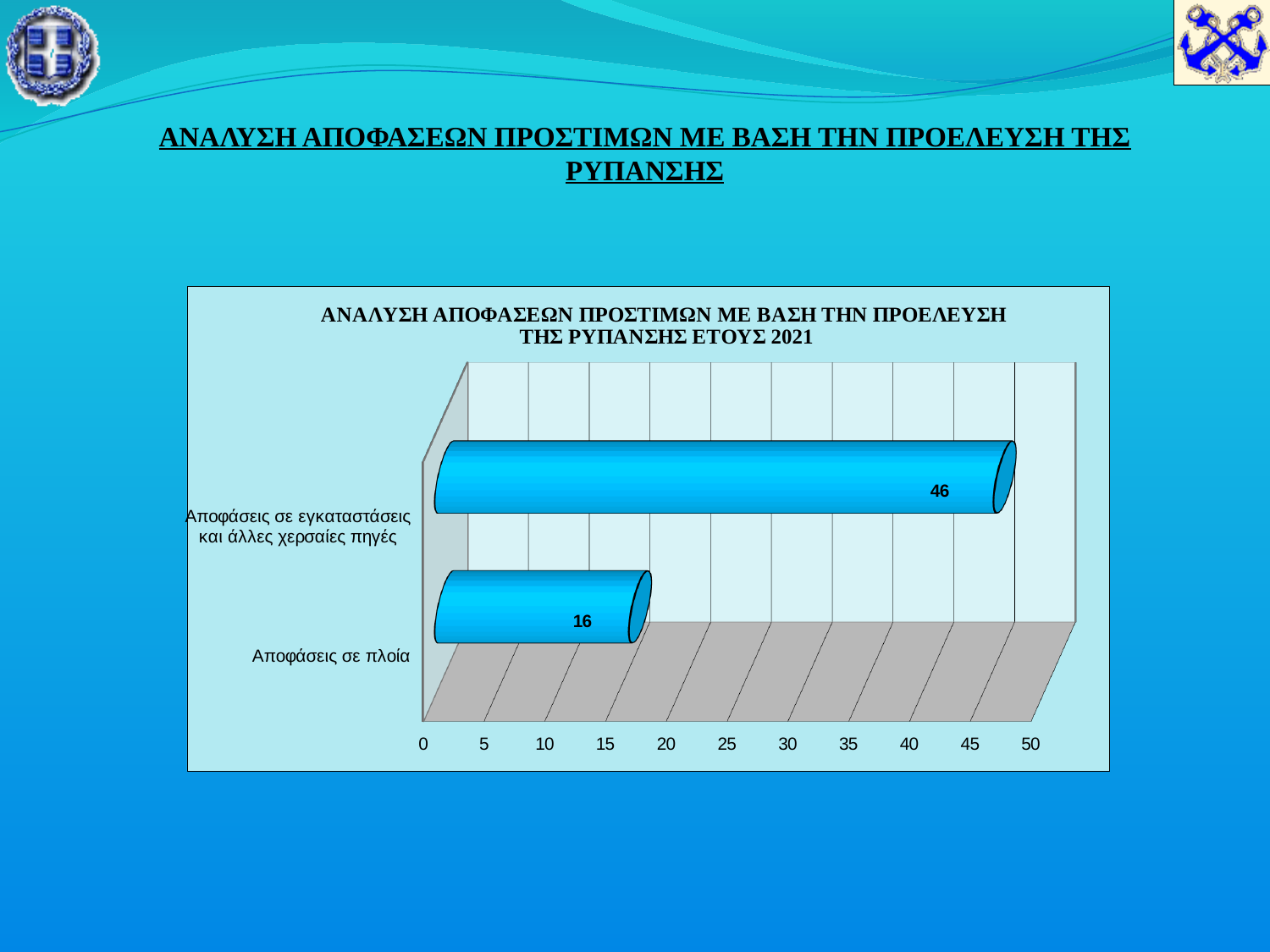
Is the value for Αποφάσεις σε εγκαταστάσεις και άλλες χερσαίες πηγές greater or less than 40? greater What is the total of the two values shown in the chart? 62 What is the title of the chart? ΑΝΑΛΥΣΗ ΑΠΟΦΑΣΕΩΝ ΠΡΟΣΤΙΜΩΝ ΜΕ ΒΑΣΗ ΤΗΝ ΠΡΟΕΛΕΥΣΗ ΤΗΣ ΡΥΠΑΝΣΗΣ ΕΤΟΥΣ 2021 What is the difference between the value for Αποφάσεις σε εγκαταστάσεις και άλλες χερσαίες πηγές and the value for Αποφάσεις σε πλοία? 30 Which category has the highest value? Αποφάσεις σε εγκαταστάσεις και άλλες χερσαίες πηγές Which category has the lowest value? Αποφάσεις σε πλοία What kind of chart is shown on the slide? Bar chart What is the value for Αποφάσεις σε εγκαταστάσεις και άλλες χερσαίες πηγές? 46 How many categories are shown in the chart? 2 What is the value for Αποφάσεις σε πλοία? 16 Which is larger: the value for Αποφάσεις σε πλοία or the value for Αποφάσεις σε εγκαταστάσεις και άλλες χερσαίες πηγές? Αποφάσεις σε εγκαταστάσεις και άλλες χερσαίες πηγές Is the value for Αποφάσεις σε πλοία greater or less than 20? less